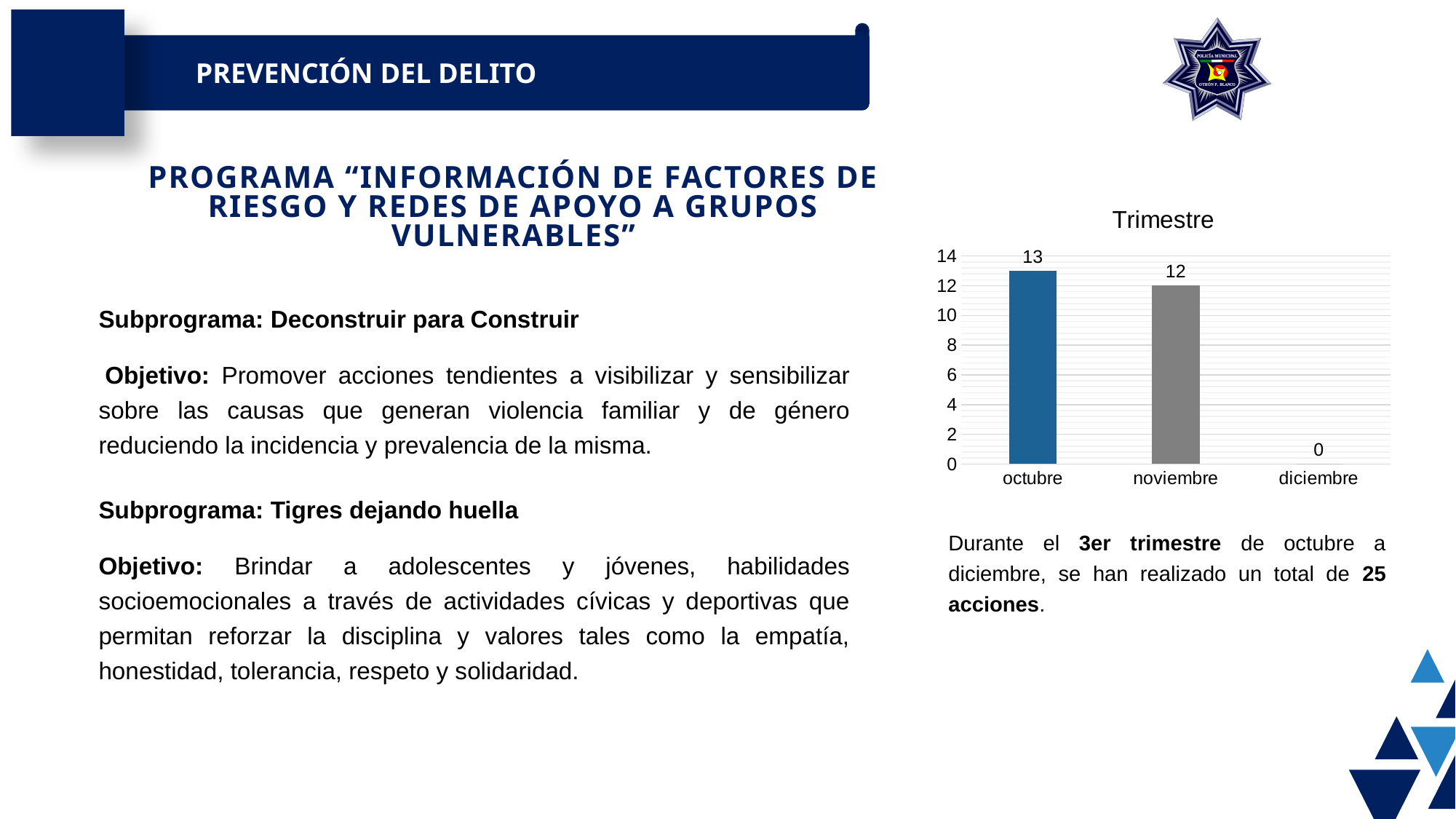
What is the value for noviembre? 12 What is the value for octubre? 13 Is the value for octubre greater or less than 10? greater Which is larger, the value for noviembre or the value for diciembre? noviembre Which month has the lowest value? diciembre Which month has the highest value? octubre What kind of chart is shown? bar chart What is the difference between the values for octubre and noviembre? 1 What is the value for diciembre? 0 What is the title of the chart? Trimestre How many categories are shown on the x axis? 3 Do the values rise or fall from octubre to diciembre? fall